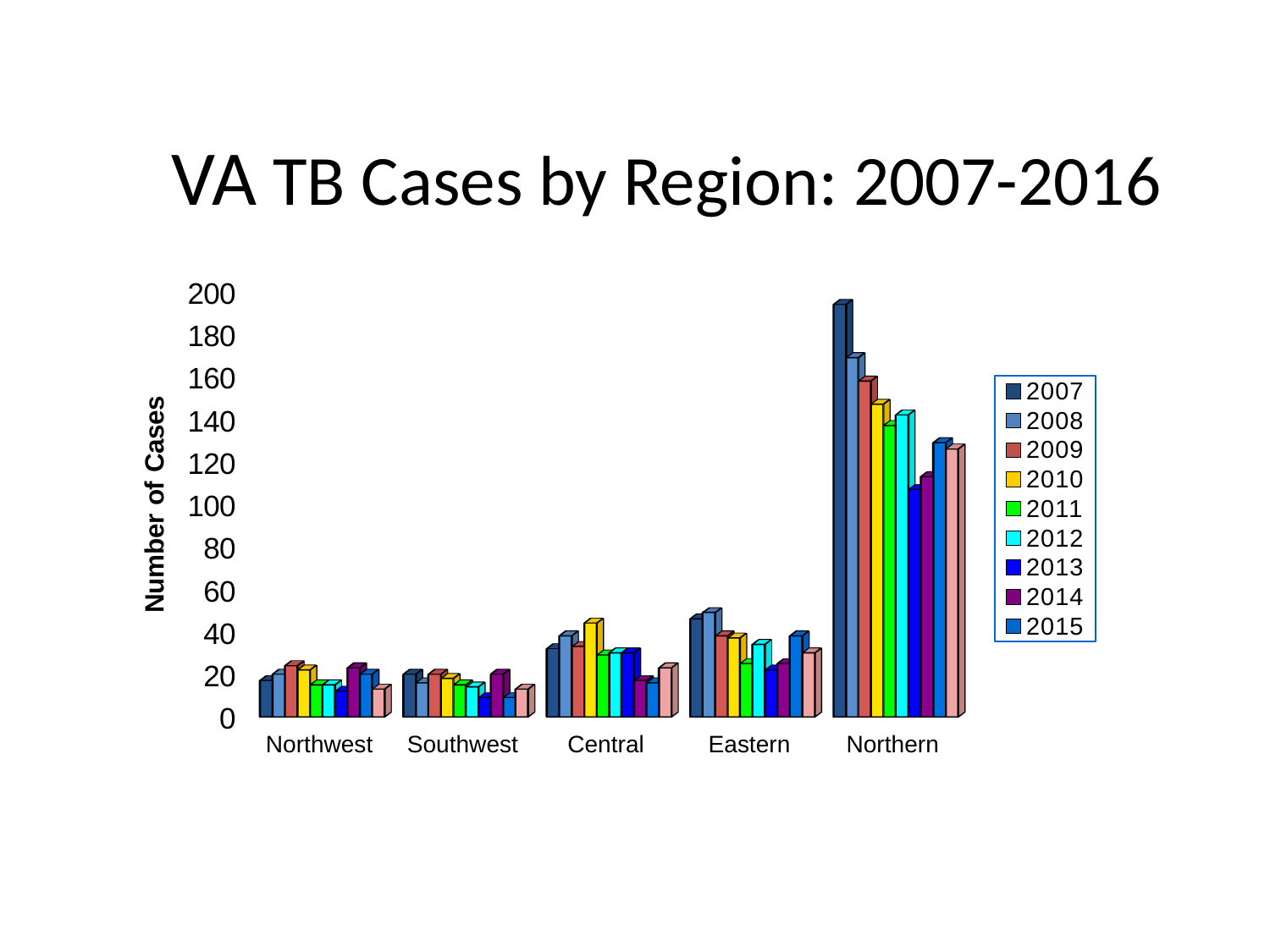
Which region has the highest number of TB cases? Northern What is the label on the vertical axis? Number of Cases How many regions are shown on the x axis? 5 What kind of chart is shown on the slide? bar chart In the Northern region, which is larger, the 2007 value or the 2014 value? 2007 Is the value for Northern in 2007 greater or less than 180? greater Is the value for Eastern in 2015 greater or less than 20? greater Which is larger, the 2007 value for Eastern or the 2007 value for Central? Eastern In the Northern region, which year has the tallest bar? 2007 Is the value for Northern in 2015 greater or less than 140? less How many years does the legend list? 9